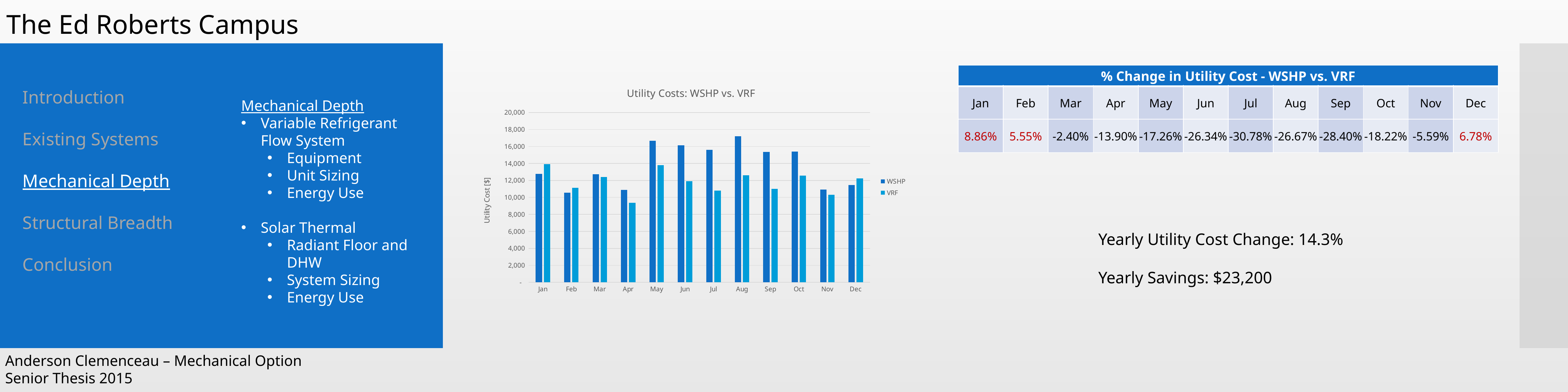
What kind of chart is shown on the slide? Bar chart How many series does the legend of the Utility Costs chart list? 2 How many months are shown on the x axis of the Utility Costs chart? 12 Is the WSHP value for Aug greater or less than 16,000? greater Is the VRF value for Jul greater or less than 12,000? less In which month is the WSHP utility cost highest? Aug In which month is the VRF utility cost lowest? Apr What is the title of the chart? Utility Costs: WSHP vs. VRF In Jan, which series has the larger utility cost, WSHP or VRF? VRF What is the label on the vertical axis of the chart? Utility Cost [$] In Aug, which series has the larger utility cost, WSHP or VRF? WSHP Is the VRF value for Apr greater or less than 10,000? less